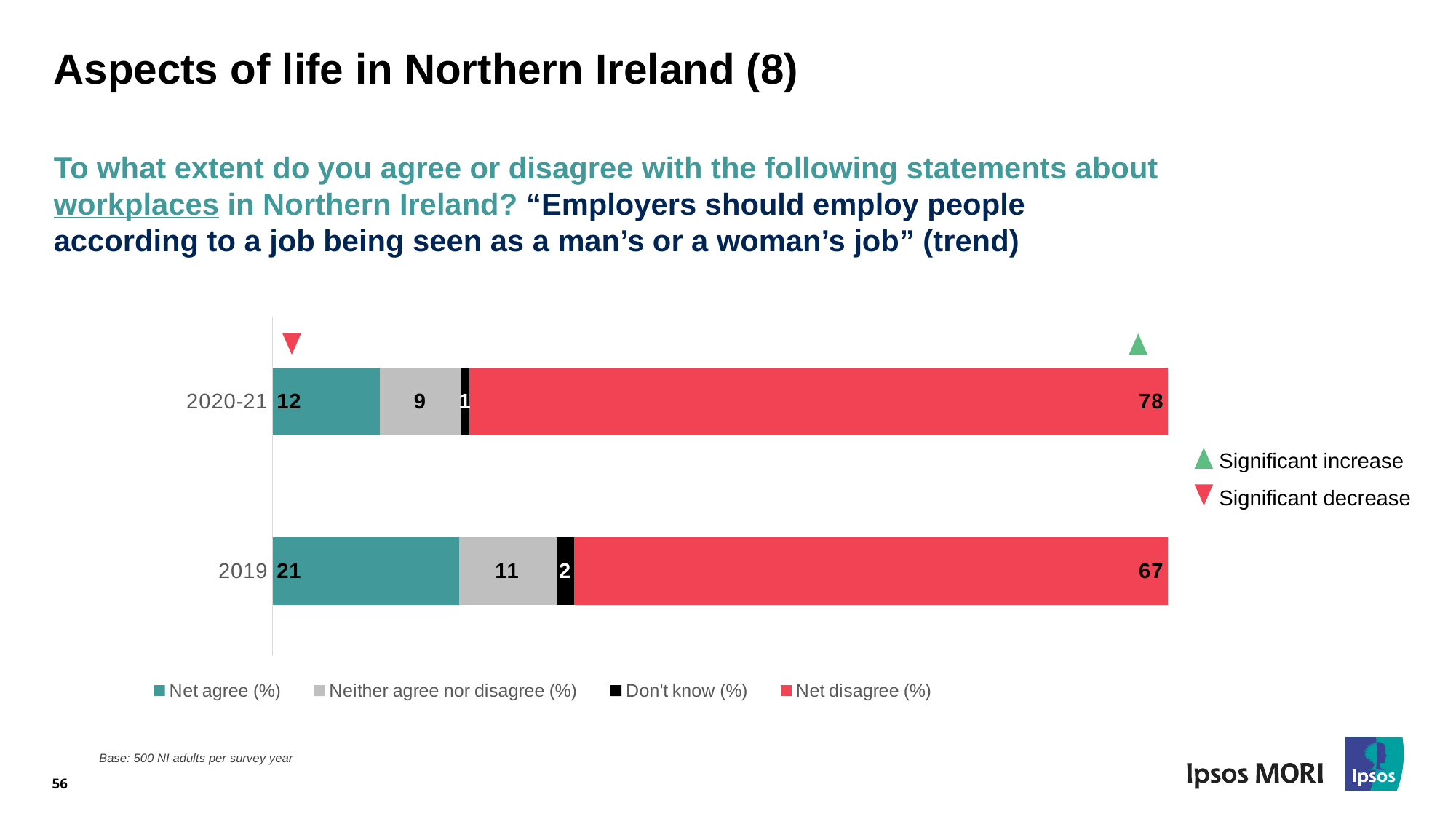
How many years are shown on the chart? 2 What kind of chart is shown on the slide? Stacked bar chart What is the difference between the Net disagree (%) values for 2020-21 and 2019? 11 What is the Net agree (%) value for 2020-21? 12 What is the Neither agree nor disagree (%) value for 2020-21? 9 What is the total of the stacked bar for 2019? 101 What is the Don't know (%) value for 2019? 2 What is the Net disagree (%) value for 2019? 67 Which year has the higher Net disagree (%) value? 2020-21 How many series does the legend list? 4 Is the Net agree (%) value larger for 2019 or for 2020-21? 2019 Which year has the lower Net agree (%) value? 2020-21